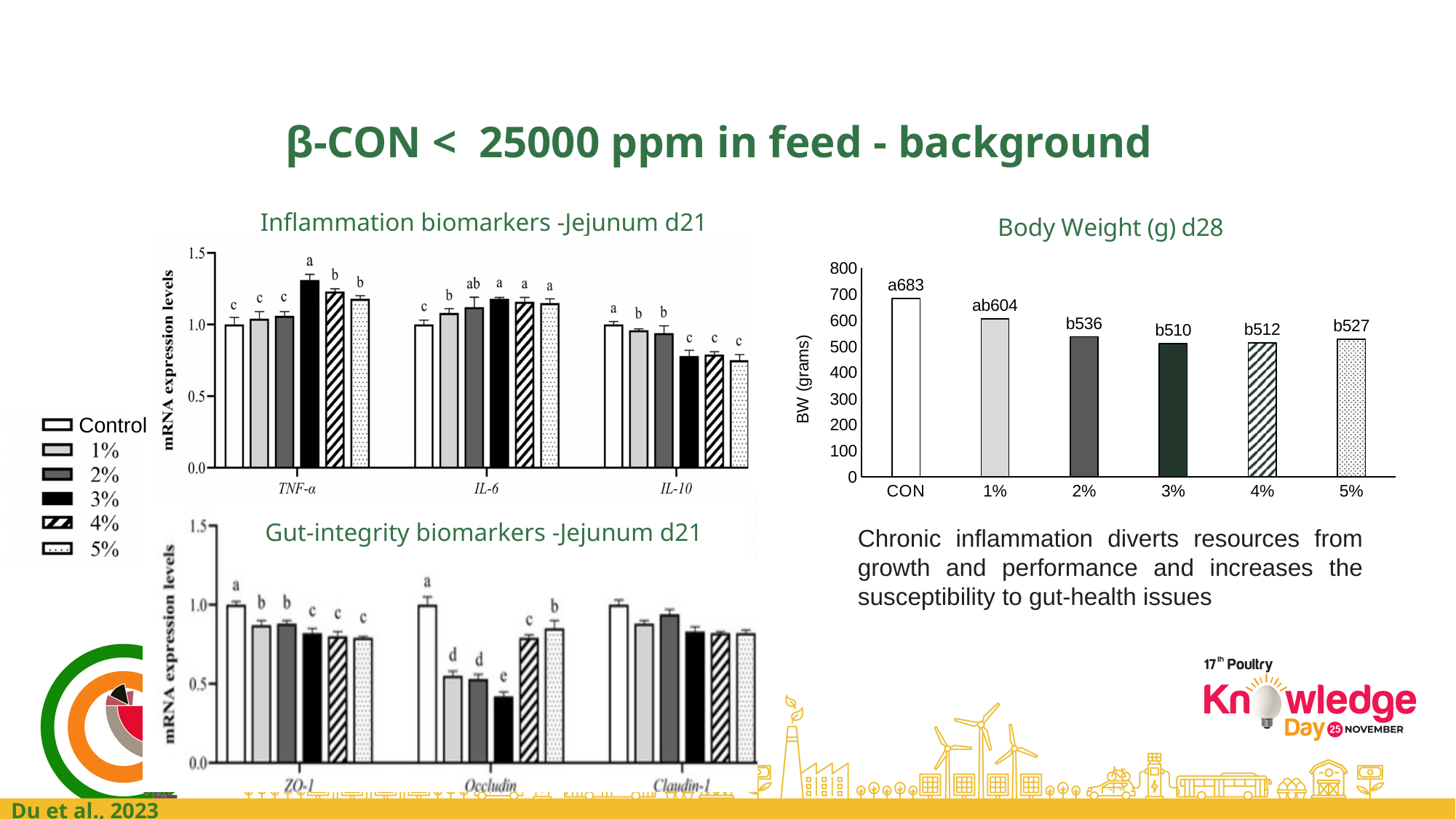
On the Body Weight (g) d28 chart, which group has the lowest body weight? 3% On the Body Weight (g) d28 chart, which group has a higher body weight, 4% or 5%? 5% On the Body Weight (g) d28 chart, what is the difference in body weight between the CON group and the 3% group? 173 On the Body Weight (g) d28 chart, how many groups are plotted? 6 How many series does the shared legend for the Jejunum d21 biomarker charts list? 6 On the Gut-integrity biomarkers - Jejunum d21 chart, is the Occludin value for the 3% group greater or less than 0.5? less On the Body Weight (g) d28 chart, what data label is printed above the 1% bar? ab604 On the Inflammation biomarkers - Jejunum d21 chart, is the TNF-α value for the 3% group greater or less than 1.0? greater On the Body Weight (g) d28 chart, what is the body weight for the 3% group? 510 On the Body Weight (g) d28 chart, what is the body weight for the CON group? 683 On the Body Weight (g) d28 chart, which group has the highest body weight? CON What kind of chart is the Body Weight (g) d28 chart? bar chart